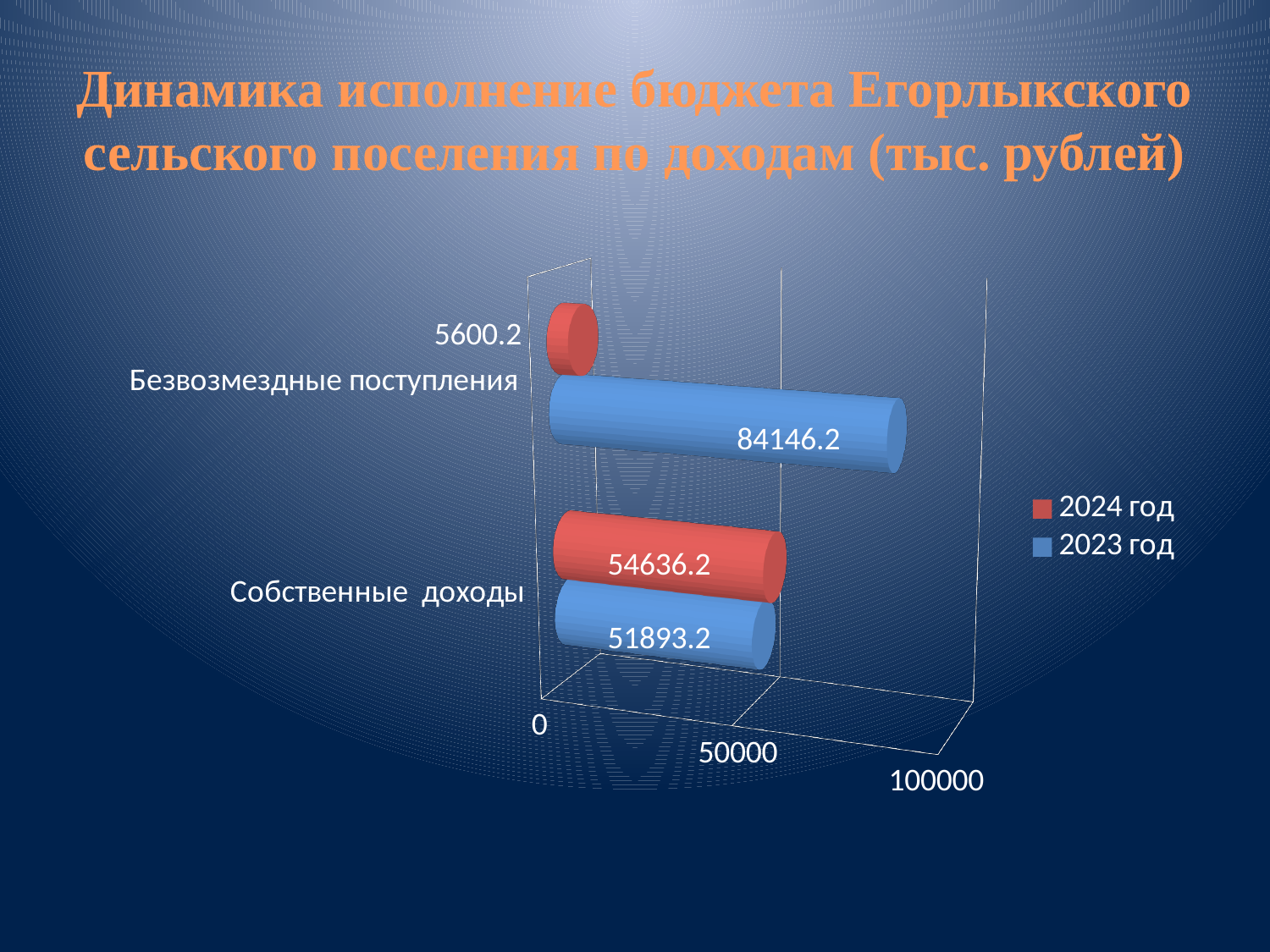
What is the difference between the 2024 год and 2023 год values for Собственные доходы? 2743.0 Which category has the highest value in the 2023 год series? Безвозмездные поступления Is the 2023 год value for Безвозмездные поступления greater or less than 50000? greater Which category has the lowest value in the 2024 год series? Безвозмездные поступления What is the value for Безвозмездные поступления in the 2024 год series? 5600.2 What is the value for Безвозмездные поступления in the 2023 год series? 84146.2 For Собственные доходы, which series has the larger value, 2024 год or 2023 год? 2024 год What is the value for Собственные доходы in the 2024 год series? 54636.2 What kind of chart is shown on the slide? Bar chart How many series does the legend list? 2 What is the value for Собственные доходы in the 2023 год series? 51893.2 What is the difference between the 2023 год and 2024 год values for Безвозмездные поступления? 78546.0